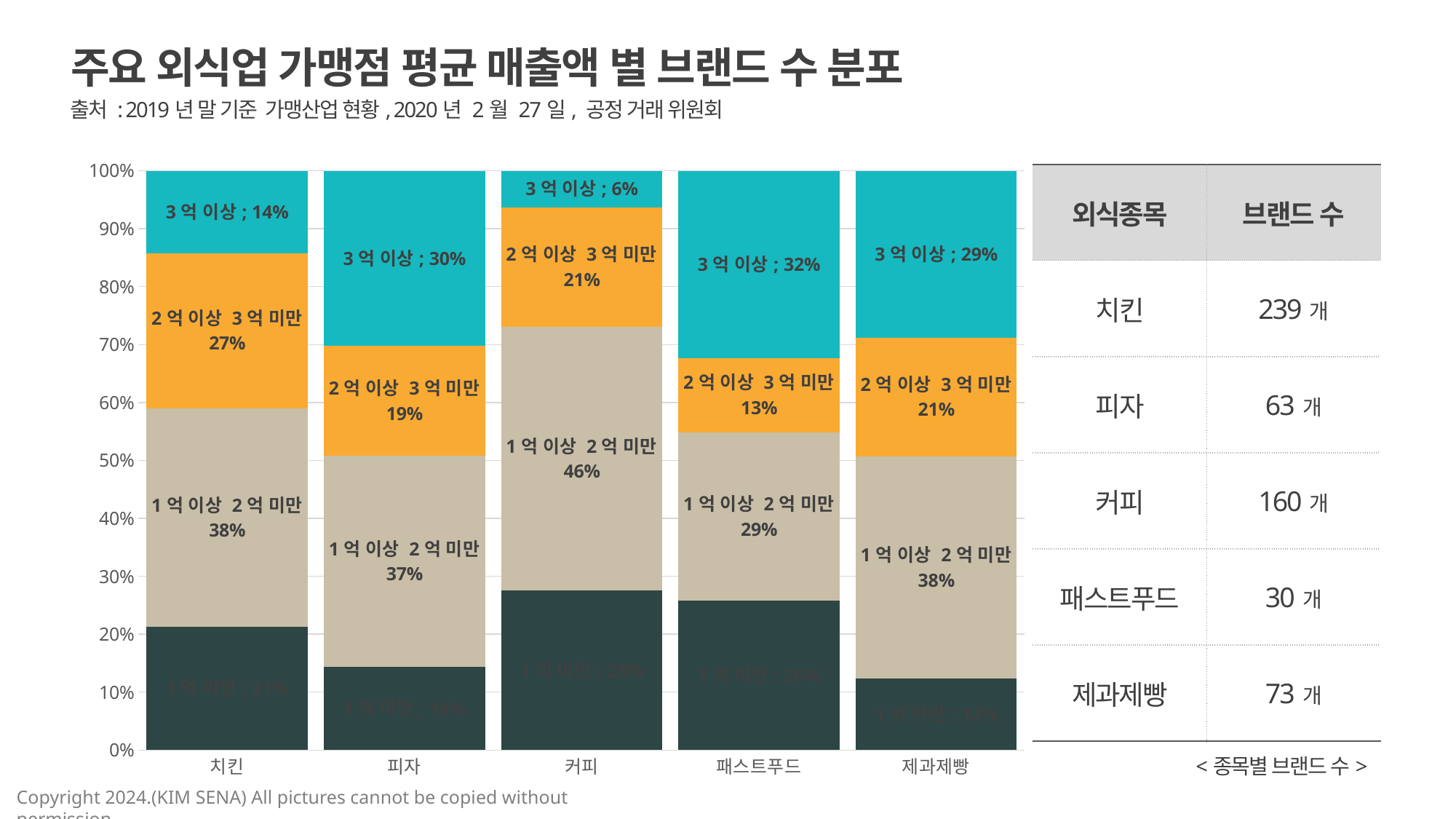
What percentage of 제과제빵 brands fall in the 1 억 이상 2 억 미만 band? 38% For 치킨, what is the difference between the 1 억 이상 2 억 미만 share and the 2 억 이상 3 억 미만 share? 11% What is the difference between the 3 억 이상 share for 패스트푸드 and for 커피? 26% Which category has the highest share of brands in the 1 억 이상 2 억 미만 band? 커피 How many restaurant categories are shown on the x axis of the chart? 5 Which category has the highest share of brands in the 3 억 이상 band? 패스트푸드 Which has a larger 3 억 이상 share, 피자 or 제과제빵? 피자 How many revenue bands are stacked in each bar? 4 What percentage of 패스트푸드 brands fall in the 2 억 이상 3 억 미만 band? 13% What percentage of 커피 brands fall in the 3 억 이상 band? 6% What type of chart is shown on the slide? Stacked bar chart Which category has the lowest share of brands in the 3 억 이상 band? 커피